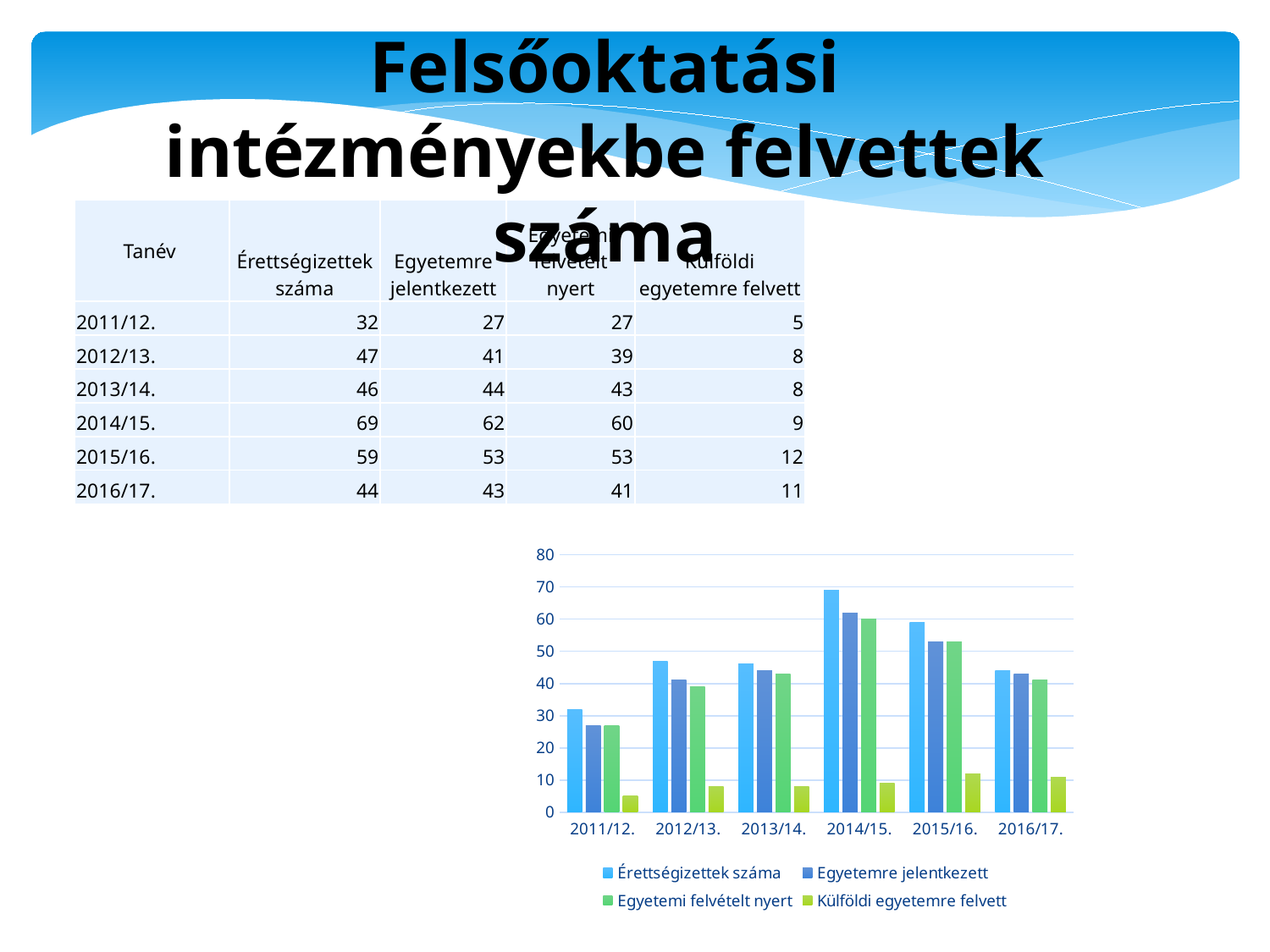
Does the value for Külföldi egyetemre felvett rise or fall from 2011/12. to 2015/16.? rise What is the difference between Érettségizettek száma and Egyetemi felvételt nyert in 2014/15.? 9 Which is larger: Egyetemre jelentkezett in 2014/15. or Egyetemre jelentkezett in 2016/17.? 2014/15. What is the value for Külföldi egyetemre felvett in 2015/16.? 12 Which school year has the lowest value for Érettségizettek száma? 2011/12. Is the value for Érettségizettek száma in 2012/13. greater or less than 40? greater Is the value for Külföldi egyetemre felvett in 2011/12. greater or less than 10? less How many school years (categories) are shown on the x axis of the chart? 6 What kind of chart is shown on the slide? bar chart How many series does the chart legend list? 4 What is the value for Érettségizettek száma in 2014/15.? 69 Which school year has the highest value for Érettségizettek száma? 2014/15.